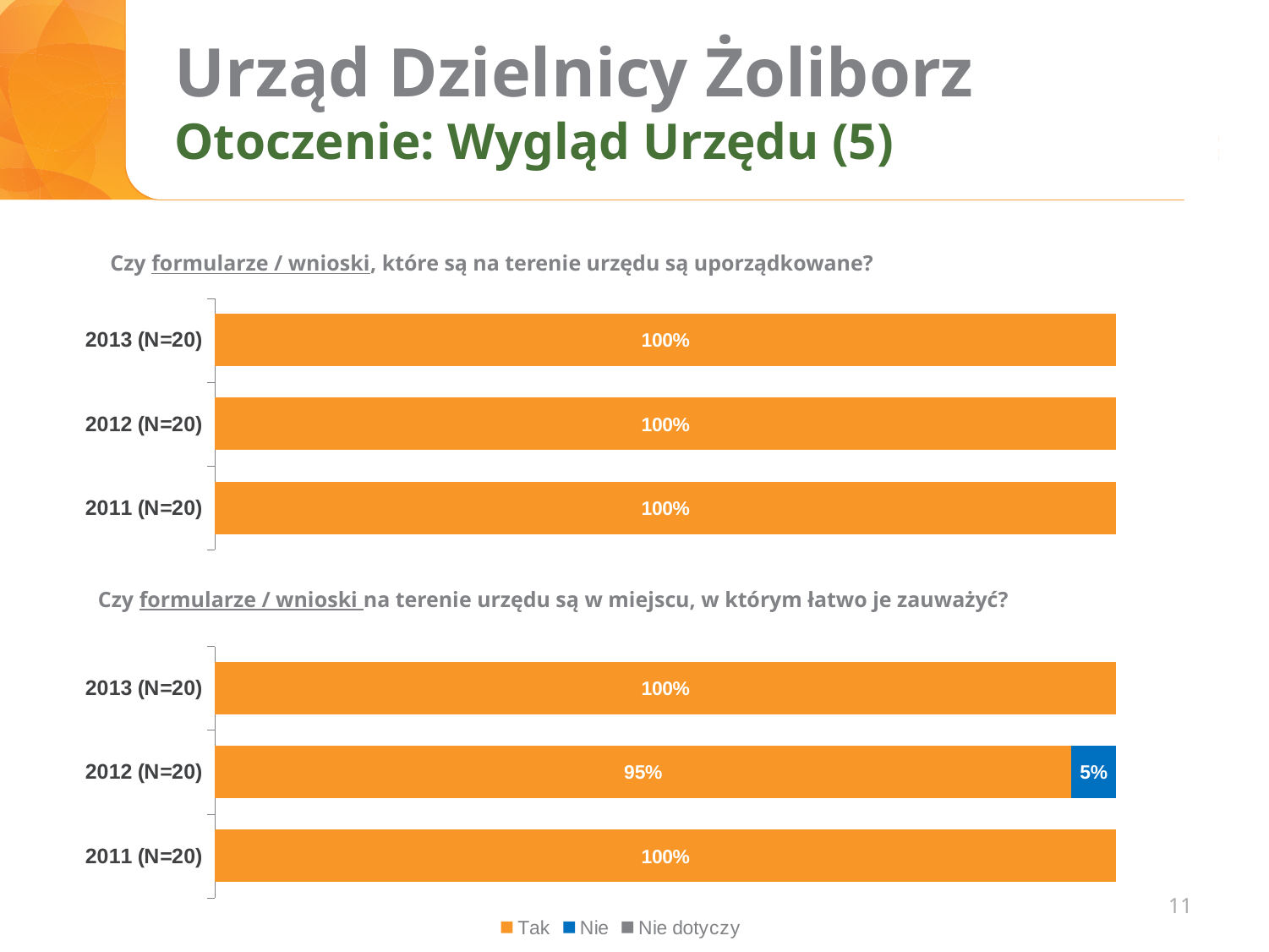
In the bottom chart ("Czy formularze / wnioski na terenie urzędu są w miejscu, w którym łatwo je zauważyć?"), what is the "Tak" value for 2012 (N=20)? 95% In the bottom chart ("Czy formularze / wnioski na terenie urzędu są w miejscu, w którym łatwo je zauważyć?"), what is the total of the stacked bar for 2012 (N=20)? 100% What are the entries in the legend at the bottom of the slide? Tak, Nie, Nie dotyczy In the bottom chart ("Czy formularze / wnioski na terenie urzędu są w miejscu, w którym łatwo je zauważyć?"), which year has the lowest "Tak" value? 2012 (N=20) In the bottom chart ("Czy formularze / wnioski na terenie urzędu są w miejscu, w którym łatwo je zauważyć?"), is the "Tak" value for 2012 (N=20) larger or smaller than the "Tak" value for 2011 (N=20)? smaller In the bottom chart ("Czy formularze / wnioski na terenie urzędu są w miejscu, w którym łatwo je zauważyć?"), what is the difference between the "Tak" values for 2013 (N=20) and 2012 (N=20)? 5% In the bottom chart ("Czy formularze / wnioski na terenie urzędu są w miejscu, w którym łatwo je zauważyć?"), what is the "Nie" value for 2012 (N=20)? 5% What type of chart is the top chart ("Czy formularze / wnioski, które są na terenie urzędu są uporządkowane?")? Bar chart How many series does the legend at the bottom of the slide list? 3 In the bottom chart ("Czy formularze / wnioski na terenie urzędu są w miejscu, w którym łatwo je zauważyć?"), what is the "Tak" value for 2011 (N=20)? 100% In the top chart ("Czy formularze / wnioski, które są na terenie urzędu są uporządkowane?"), what is the "Tak" value for 2013 (N=20)? 100% How many year categories are shown in the top chart ("Czy formularze / wnioski, które są na terenie urzędu są uporządkowane?")? 3